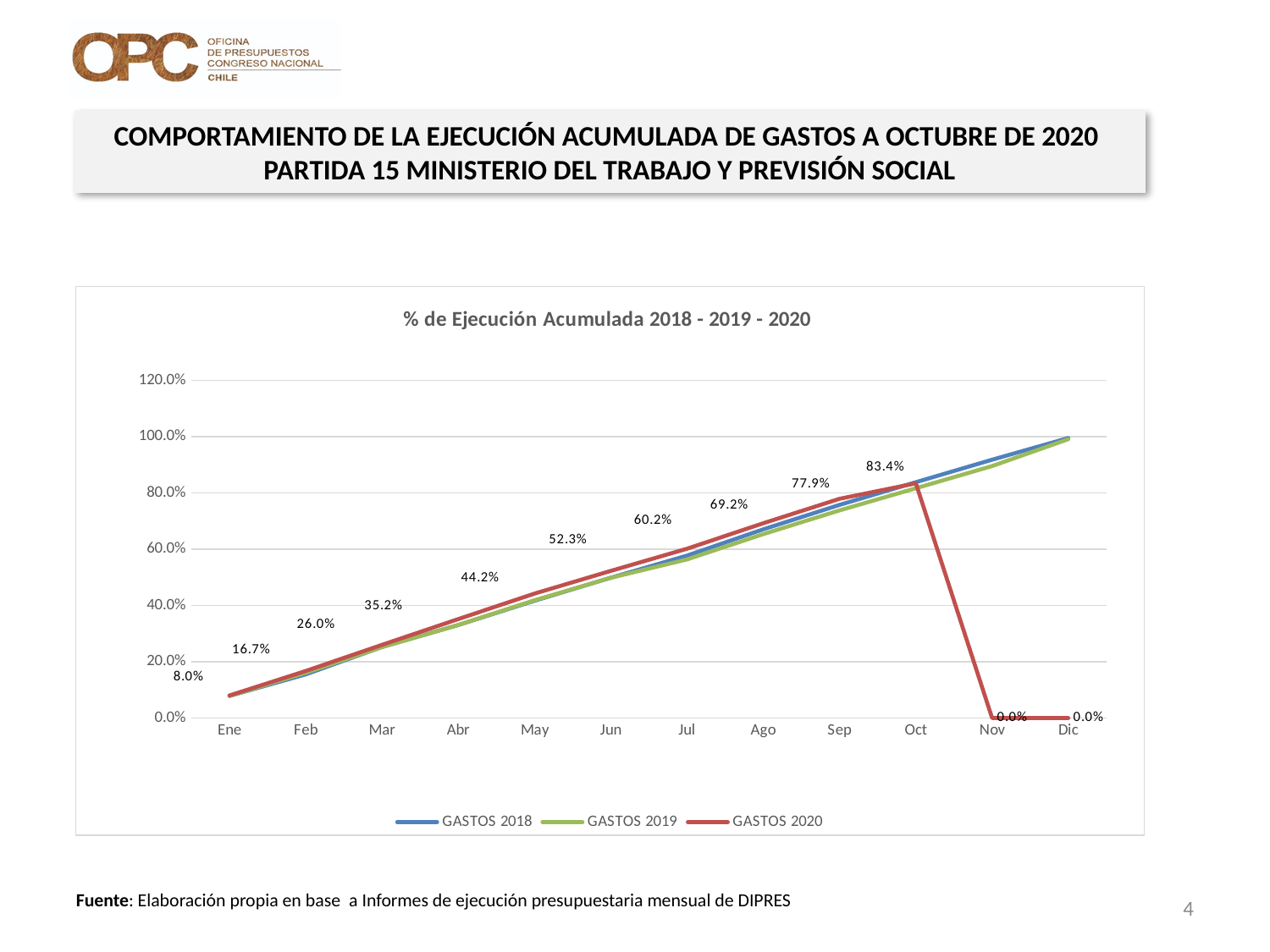
How many months are shown on the x axis? 12 What is the difference between the GASTOS 2020 values for Jul and Jun? 7.9% What is the difference between the GASTOS 2020 values for Oct and Sep? 5.5% What is the value for GASTOS 2020 in Ene? 8.0% What is the value for GASTOS 2020 in Oct? 83.4% What is the value for GASTOS 2020 in Sep? 77.9% How many series does the legend list? 3 Is the value for GASTOS 2018 in Dic greater or less than 80.0%? greater What kind of chart is shown on the slide? line chart What is the value for GASTOS 2020 in May? 44.2% Is the GASTOS 2020 value for Ago larger than the value for Abr? Yes Which month has the highest GASTOS 2020 value? Oct